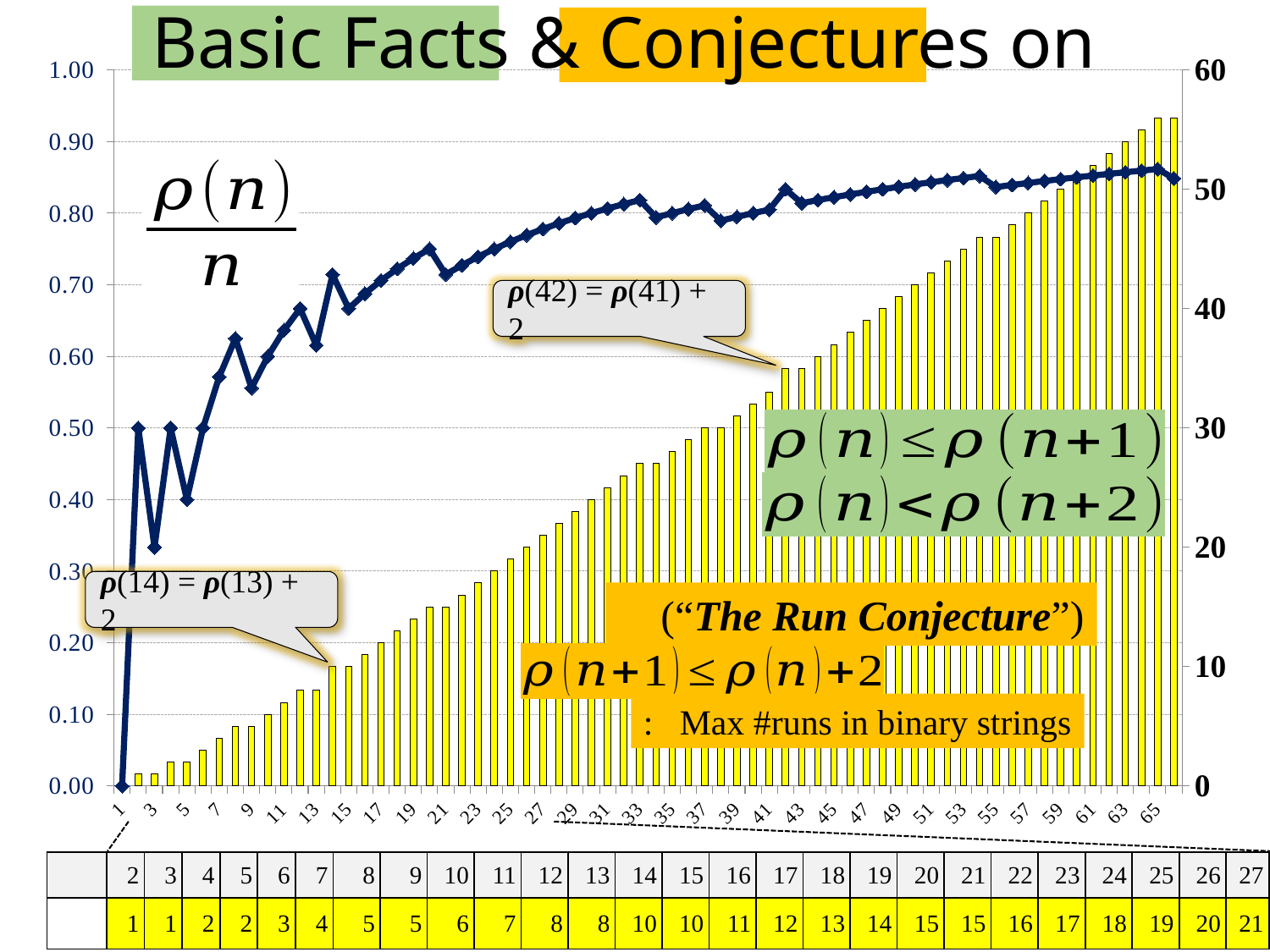
According to the table below the chart, what is the value of ρ(n) for n = 14? 10 Do the yellow bars generally rise or fall as n increases along the x axis? rise Using the table below the chart, which is larger, ρ(20) or ρ(21)? They are equal (15) What is the maximum value shown on the right-hand vertical axis? 60 What kind of chart is shown on the slide? A combination bar and line chart Is the tallest yellow bar at the right end of the chart greater or less than 50 on the right-hand axis? greater According to the table below the chart, what is the value of ρ(n) for n = 13? 8 Using the table below the chart, what is the difference between ρ(14) and ρ(13)? 2 According to the table below the chart, what is the value of ρ(n) for n = 27? 21 What does the callout pointing at the bar for n = 42 say? ρ(42) = ρ(41) + 2 Is the yellow bar for n = 42 greater or less than 30 on the right-hand axis? greater Is the value of the ρ(n)/n line at n = 3 greater or less than 0.40? less